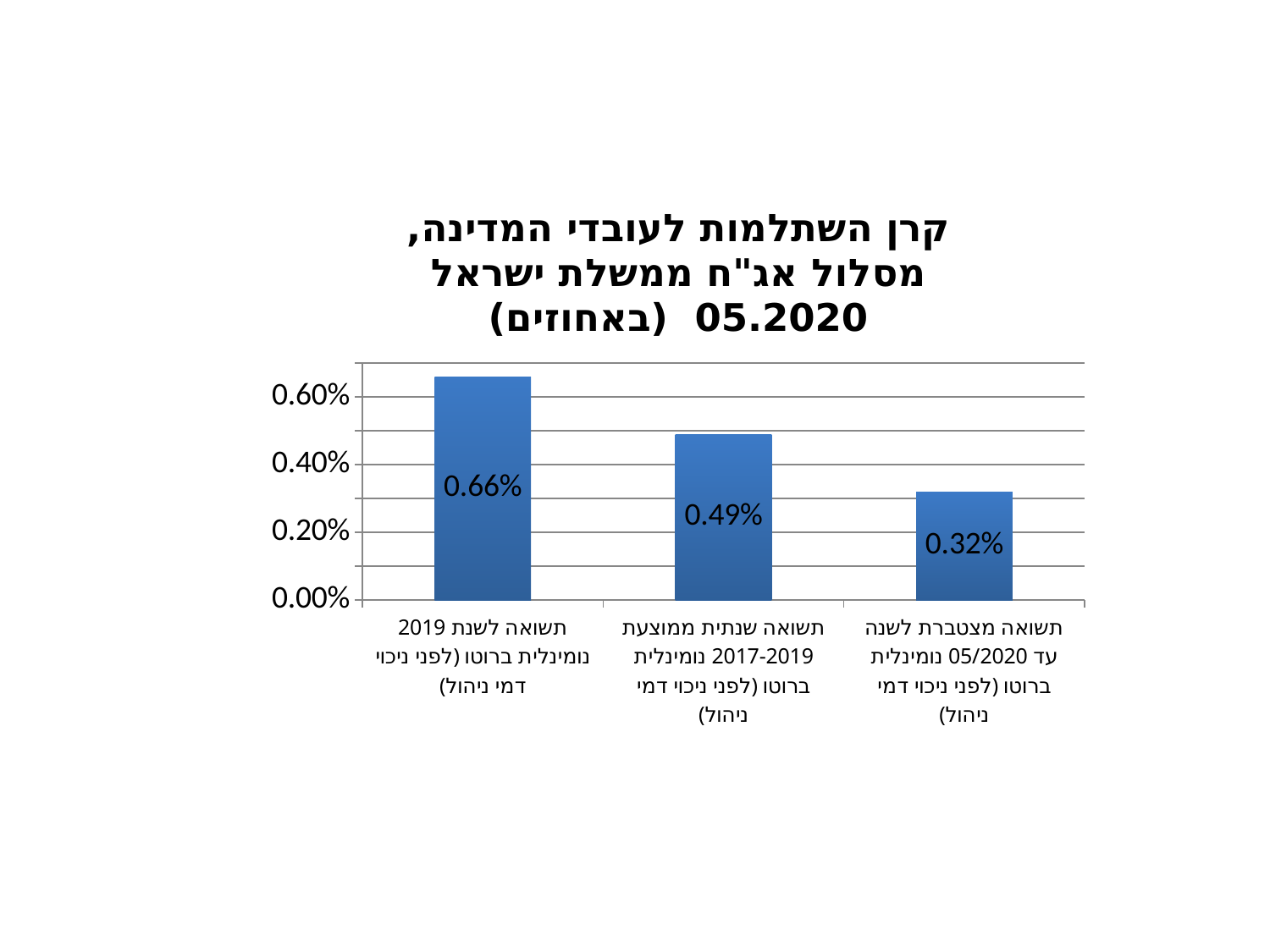
Which category has the lowest value? תשואה מצטברת לשנה עד 05/2020 נומינלית ברוטו (לפני ניכוי דמי ניהול) Do the values rise or fall from left to right across the bars? fall Which category has the highest value? תשואה לשנת 2019 נומינלית ברוטו (לפני ניכוי דמי ניהול) Which is larger: the average annual return 2017-2019 or the cumulative return to 05/2020? תשואה שנתית ממוצעת 2017-2019 Is the value for the average annual return 2017-2019 greater or less than 0.40%? greater What kind of chart is shown on the slide? bar chart What is the value for the cumulative return for the year to 05/2020 (תשואה מצטברת לשנה עד 05/2020)? 0.32% What is the value for the 2019 nominal gross return (תשואה לשנת 2019 נומינלית ברוטו)? 0.66% What is the difference between the 2019 return and the average annual return 2017-2019? 0.17% How many bars are shown in the chart? 3 What is the difference between the 2019 return (0.66%) and the cumulative return to 05/2020 (0.32%)? 0.34% What is the value for the average annual nominal gross return 2017-2019 (תשואה שנתית ממוצעת 2017-2019)? 0.49%